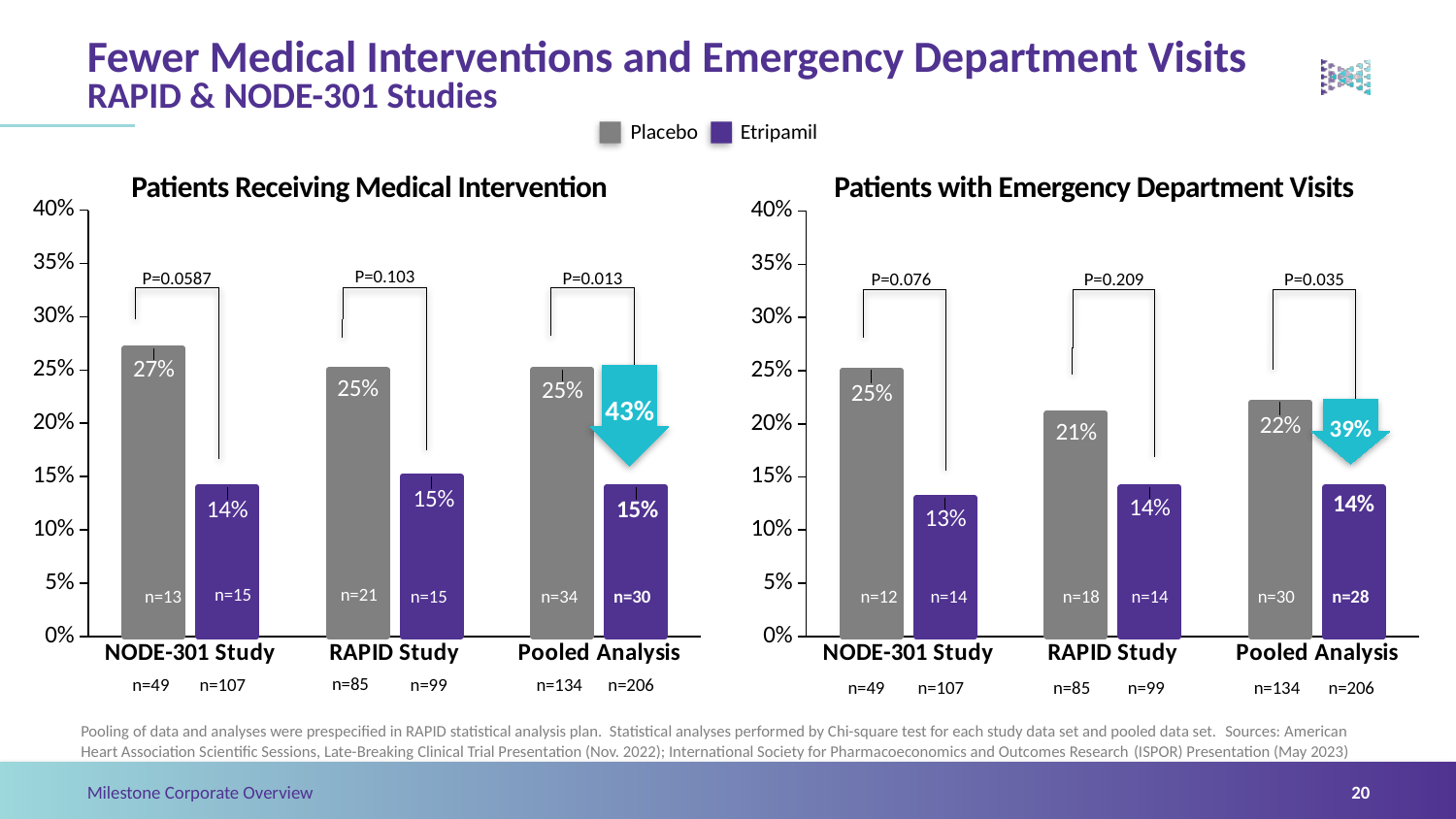
How many series does the legend list? 2 In the 'Patients with Emergency Department Visits' chart, what is the Placebo value for the RAPID Study? 21% In the 'Patients with Emergency Department Visits' chart, which study has the lowest Placebo value? RAPID Study In the 'Patients Receiving Medical Intervention' chart, what is the difference between the Placebo and Etripamil values for the NODE-301 Study? 13% What kind of chart is the 'Patients with Emergency Department Visits' chart? Bar chart In the 'Patients Receiving Medical Intervention' chart, which study has the highest Placebo value? NODE-301 Study In the 'Patients with Emergency Department Visits' chart, what is the Etripamil value for the NODE-301 Study? 13% In the 'Patients with Emergency Department Visits' chart, what is the difference between the Placebo and Etripamil values for the Pooled Analysis? 8% In the 'Patients Receiving Medical Intervention' chart, what is the Etripamil value for the Pooled Analysis? 15% In the 'Patients with Emergency Department Visits' chart, which is larger for the RAPID Study: the Placebo value or the Etripamil value? Placebo In the 'Patients Receiving Medical Intervention' chart, what is the Placebo value for the NODE-301 Study? 27% How many categories are shown on the x axis of the 'Patients Receiving Medical Intervention' chart? 3